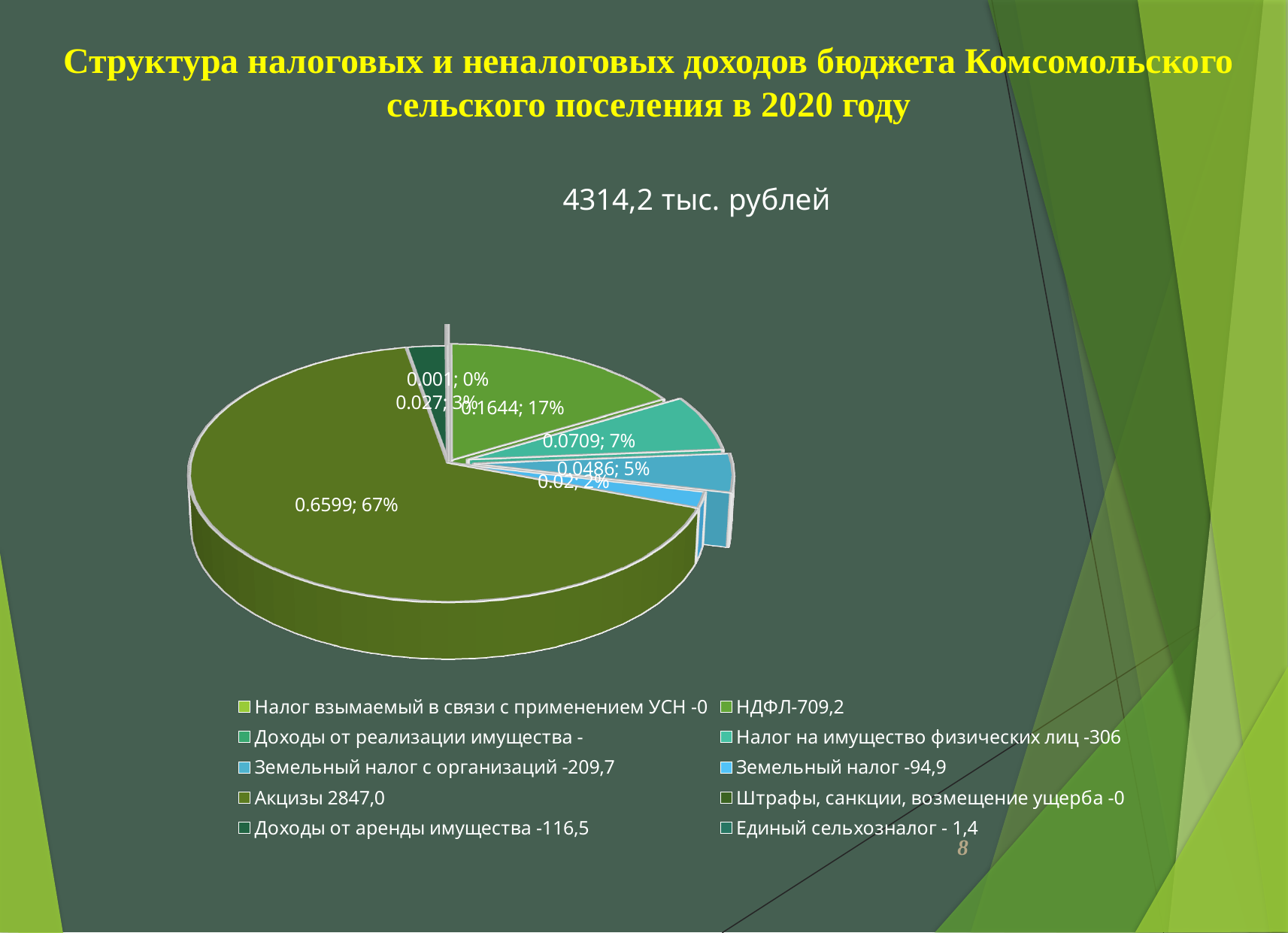
How many entries does the legend of the pie chart list? 10 What percentage share is shown on the slice labelled 0.0486? 5% What is the smallest percentage share printed on the pie chart? 0% What percentage share is shown on the slice labelled 0.1644? 17% What is the title shown above the pie chart? 4314,2 тыс. рублей What value is listed in the legend for НДФЛ? 709,2 Which is larger: the slice labelled 0.0709 or the slice labelled 0.0486? 0.0709 What percentage share is shown on the largest slice of the pie chart? 67% What value label accompanies the 67% slice of the pie chart? 0.6599 What kind of chart is shown on the slide? pie chart What value is listed in the legend for Акцизы? 2847,0